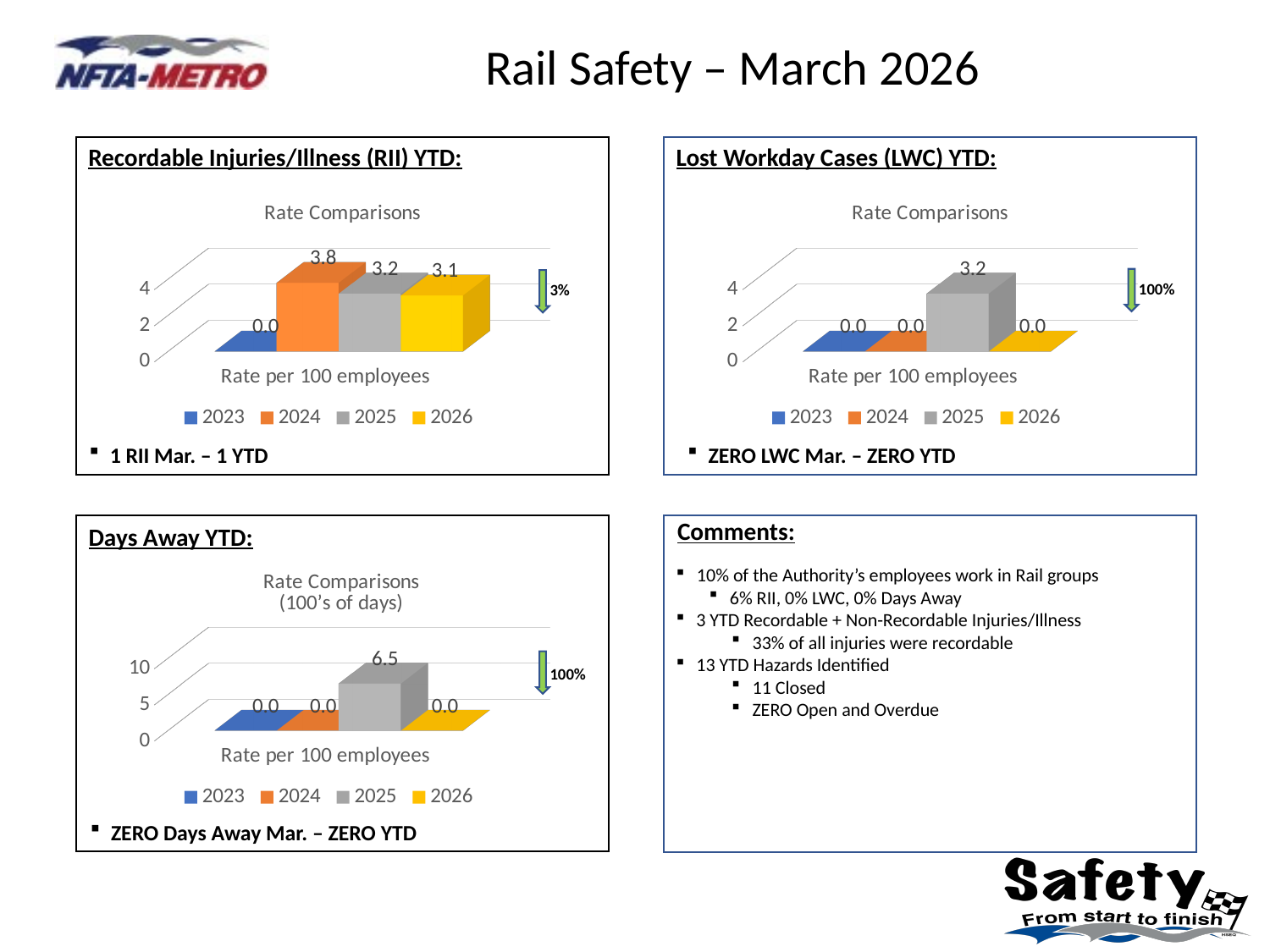
In the Lost Workday Cases (LWC) YTD chart, what is the value for 2026? 0.0 How many series does the legend of the Days Away YTD chart list? 4 What is the x-axis category label in the Recordable Injuries/Illness (RII) YTD chart? Rate per 100 employees In the Recordable Injuries/Illness (RII) YTD chart, what is the difference between the 2024 and 2025 values? 0.6 In the Days Away YTD chart, which year has the highest value? 2025 In the Recordable Injuries/Illness (RII) YTD chart, which year has the highest rate? 2024 In the Recordable Injuries/Illness (RII) YTD chart, what is the value for 2026? 3.1 In the Days Away YTD chart, what is the value for 2025? 6.5 In the Recordable Injuries/Illness (RII) YTD chart, which is larger, the value for 2025 or the value for 2026? 2025 In the Lost Workday Cases (LWC) YTD chart, what is the value for 2025? 3.2 What kind of chart is the Lost Workday Cases (LWC) YTD chart? Bar chart In the Recordable Injuries/Illness (RII) YTD chart, what is the value for 2024? 3.8